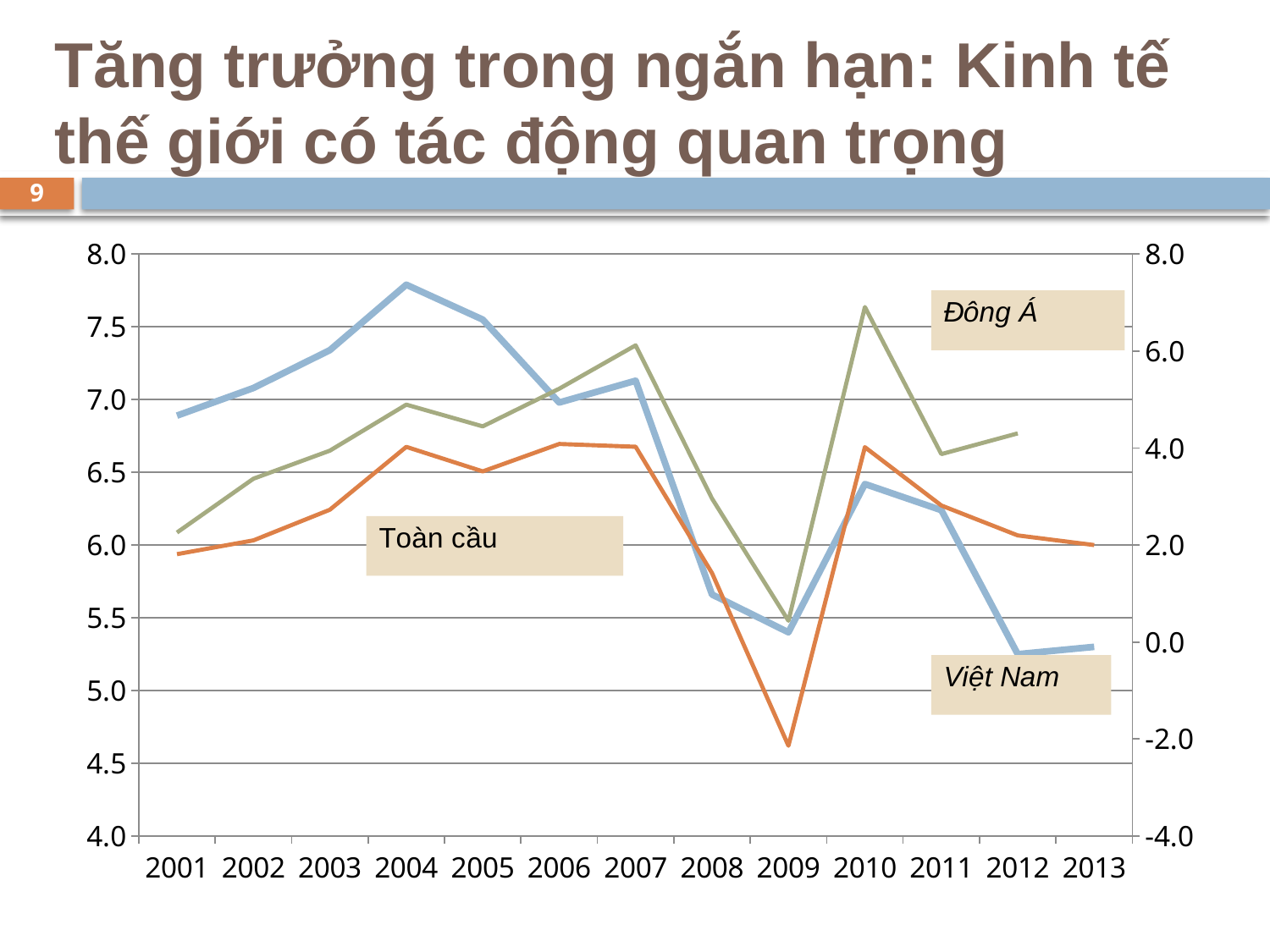
How many years are shown along the x axis of the chart? 13 Is the value for Việt Nam in 2012 greater or less than 6.0? less How many series are labelled on the chart? 3 Which series is labelled in the box at the top right of the chart? Đông Á Is the value for Toàn cầu in 2009 greater or less than 5.0? less Which is larger for Việt Nam: the value in 2004 or the value in 2012? 2004 In which year does the Toàn cầu line reach its lowest point? 2009 What kind of chart is shown on the slide? Line chart In which year does the Đông Á line reach its highest point? 2010 In which year does the Việt Nam line reach its highest point? 2004 Is the value for Việt Nam in 2004 greater or less than 7.0? greater Does the Việt Nam line rise or fall from 2010 to 2012? Fall